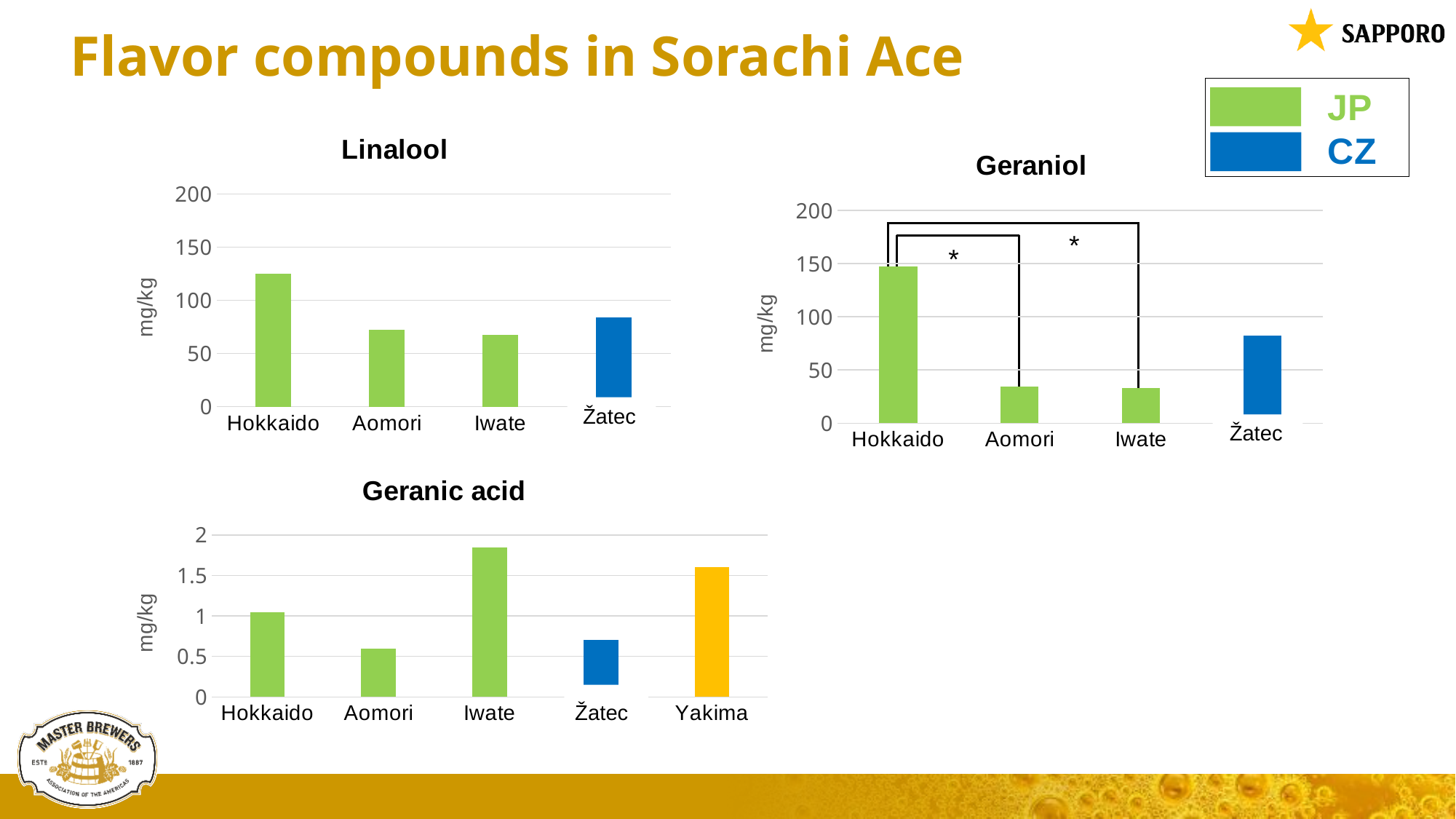
What kind of chart is the Geraniol chart? bar chart According to the legend on the slide, which colour represents CZ? blue In the Geraniol chart, which category has the highest value? Hokkaido In the Geraniol chart, is the value for Aomori greater or less than 50? less How many categories are shown on the x axis of the Linalool chart? 4 In the Geranic acid chart, which is larger, the value for Iwate or the value for Yakima? Iwate In the Linalool chart, which category has the highest value? Hokkaido In the Geraniol chart, which is larger, the value for Hokkaido or the value for Žatec? Hokkaido In the Geranic acid chart, is the value for Aomori greater or less than 1? less In the Linalool chart, is the value for Hokkaido greater or less than 100? greater In the Geranic acid chart, which category has the highest value? Iwate How many categories are shown on the x axis of the Geranic acid chart? 5